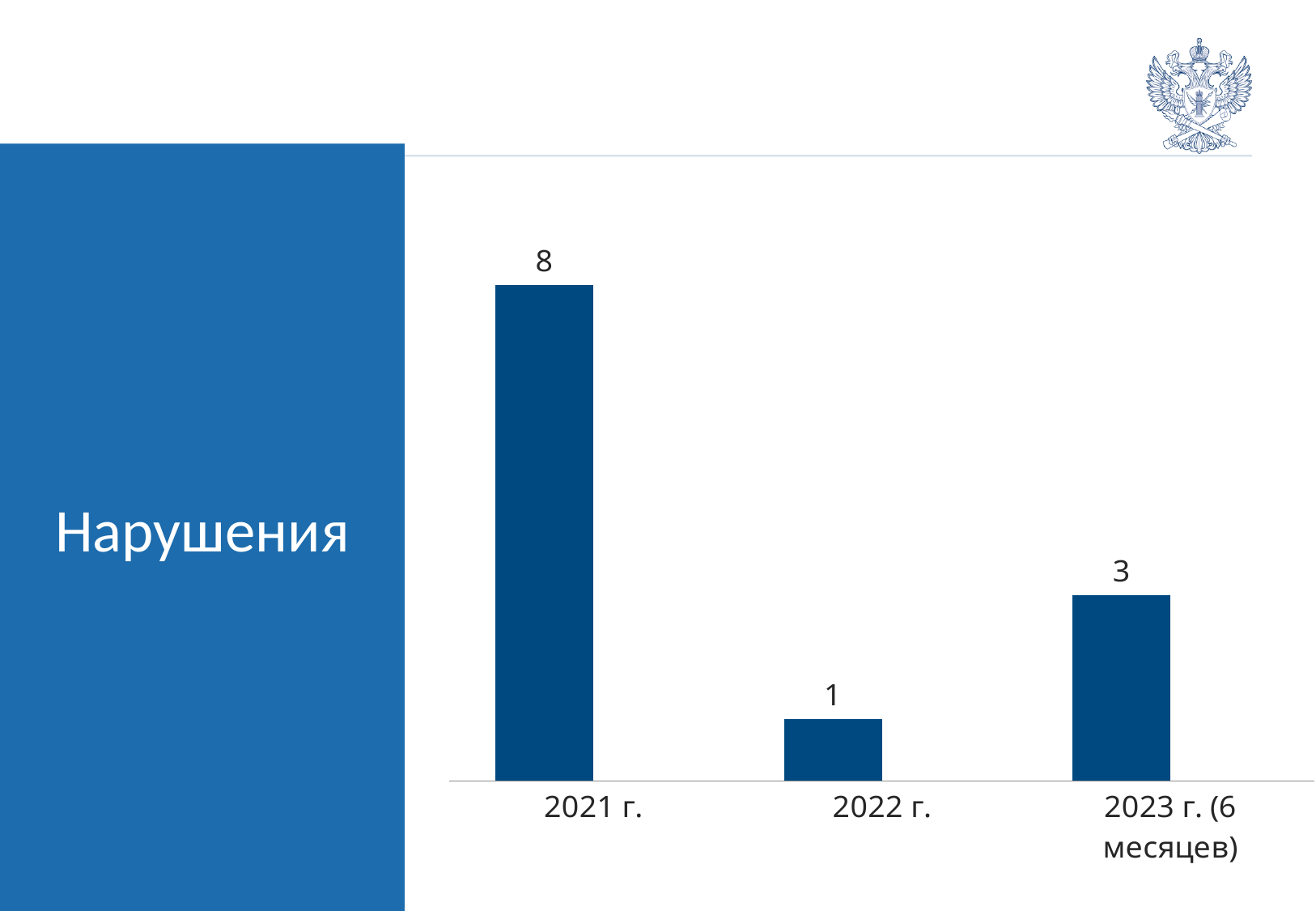
What kind of chart is shown on the slide? bar chart Which is larger, the value for 2021 г. or the value for 2023 г. (6 месяцев)? 2021 г. What is the title shown on the left panel of the slide? Нарушения How many categories are shown on the x axis? 3 What is the value for 2023 г. (6 месяцев)? 3 What is the difference between the values for 2021 г. and 2022 г.? 7 What is the difference between the values for 2023 г. (6 месяцев) and 2022 г.? 2 Which category has the highest value? 2021 г. What is the value for 2021 г.? 8 Which category has the lowest value? 2022 г. Does the value rise or fall from 2021 г. to 2022 г.? fall What is the value for 2022 г.? 1